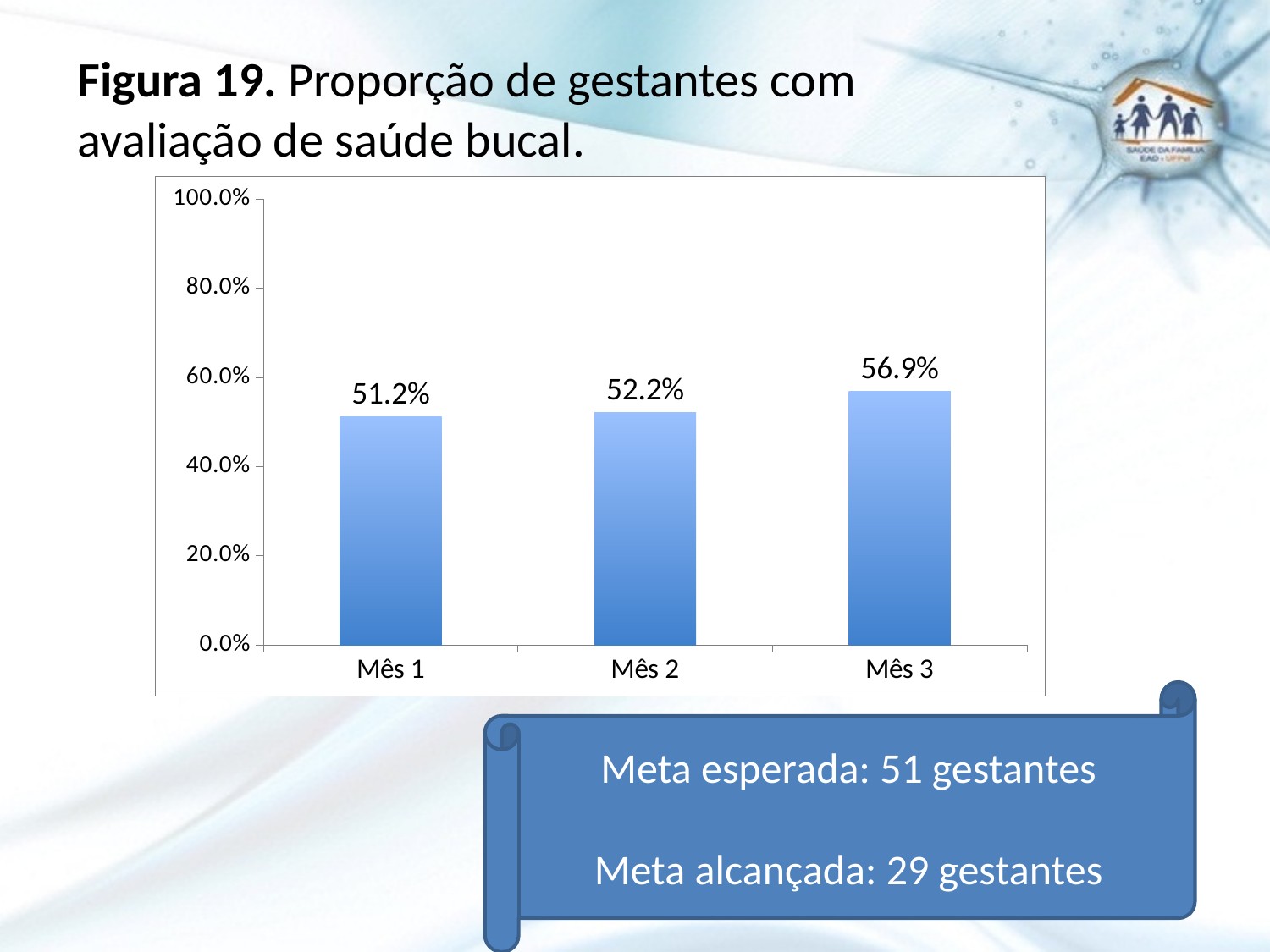
Which is larger, the value for Mês 3 or the value for Mês 2? Mês 3 What is the difference between the values for Mês 2 and Mês 1? 1.0% Is the value for Mês 3 greater or less than 60.0%? less How many months are shown on the x axis? 3 What is the value for Mês 3? 56.9% What kind of chart is shown on the slide? bar chart Which month has the highest value? Mês 3 Do the values rise or fall from Mês 1 to Mês 3? rise What is the value for Mês 2? 52.2% Which month has the lowest value? Mês 1 What is the value for Mês 1? 51.2% What is the difference between the values for Mês 3 and Mês 1? 5.7%